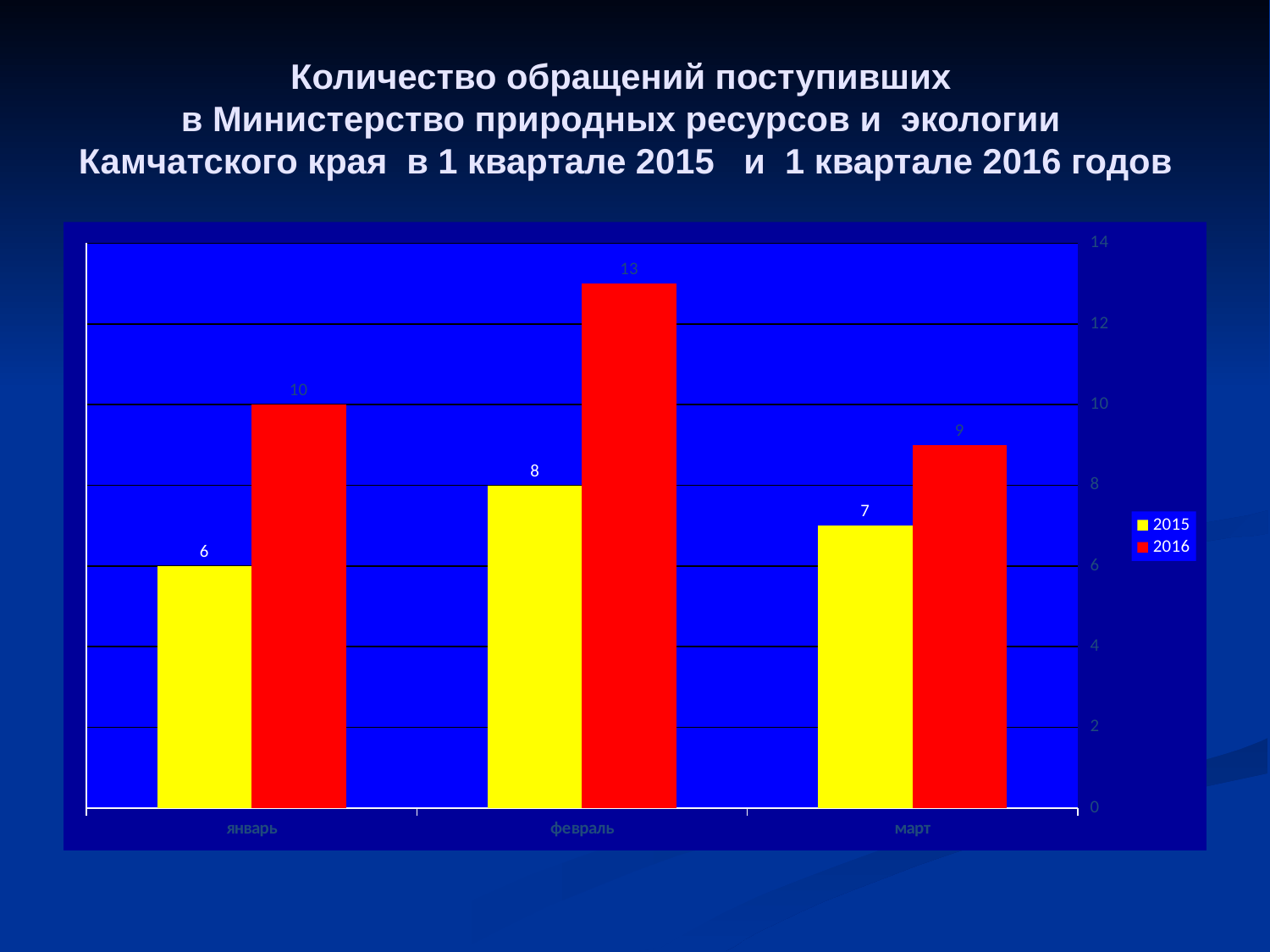
Which month has the highest value for 2016? февраль What is the value for 2015 in февраль? 8 What is the value for 2015 in январь? 6 What kind of chart is shown on the slide? bar chart Which colour represents the 2016 series? red What is the difference between the 2016 and 2015 values in февраль? 5 Which month has the lowest value for 2015? январь What is the value for 2016 in март? 9 How many series does the legend list? 2 What is the value for 2016 in февраль? 13 How many months are shown on the x axis? 3 Which is larger in март: the 2015 value or the 2016 value? 2016